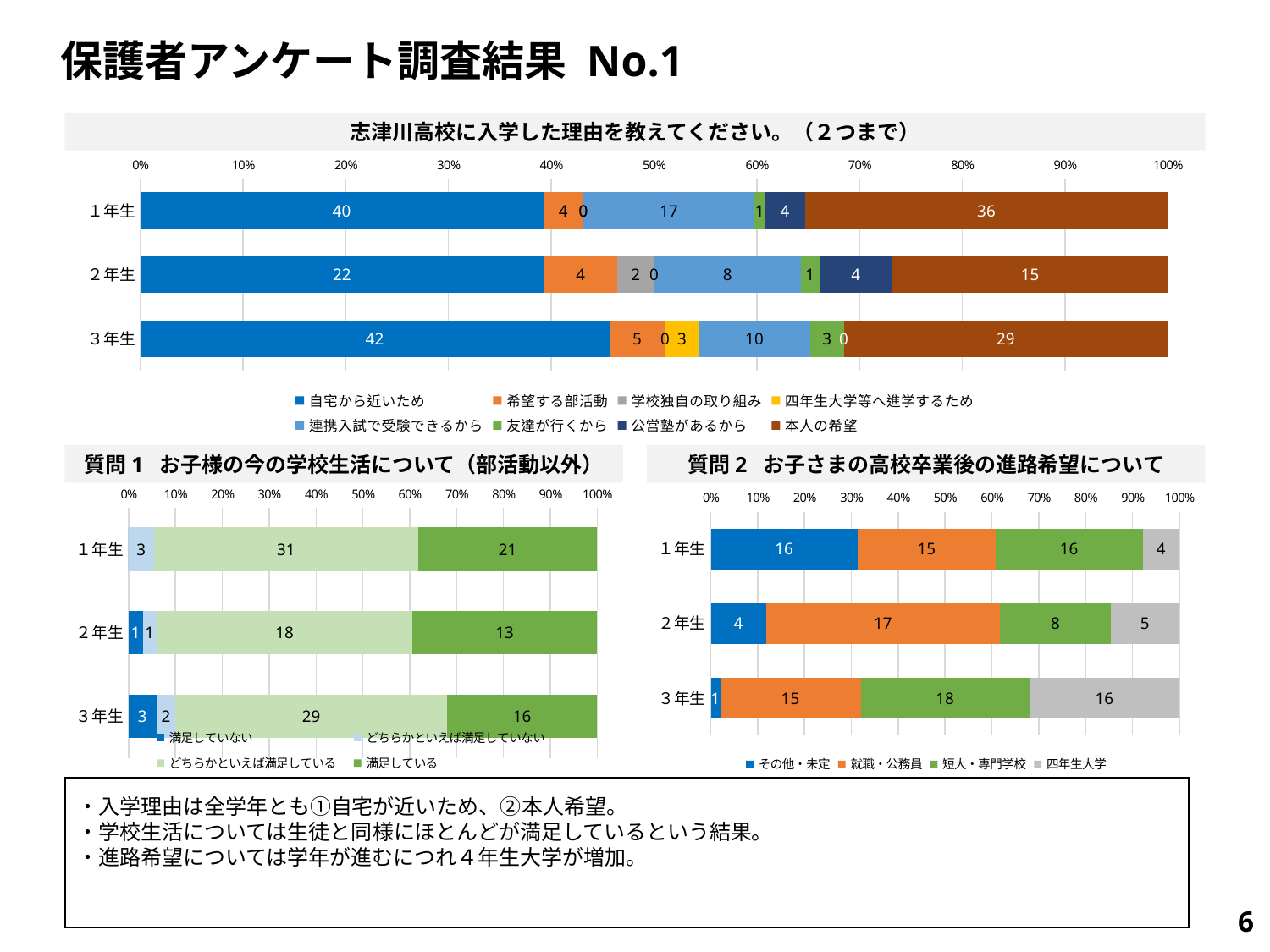
In the 質問1 chart (bottom left), what is the value of どちらかといえば満足している for 1年生? 31 In the 質問2 chart (bottom right), which grade has the highest value for 就職・公務員? 2年生 In the top chart (志津川高校に入学した理由), what is the difference between 自宅から近いため for 3年生 and for 2年生? 20 In the 質問1 chart (bottom left), what is the value of 満足している for 2年生? 13 In the top chart (志津川高校に入学した理由), what is the value of 連携入試で受験できるから for 2年生? 8 In the top chart (志津川高校に入学した理由), what is the value of 自宅から近いため for 3年生? 42 In the 質問2 chart (bottom right), what is the value of 四年生大学 for 3年生? 16 In the 質問2 chart (bottom right), which is larger for 1年生: その他・未定 or 四年生大学? その他・未定 In the 質問2 chart (bottom right), how many grade categories are shown? 3 In the top chart (志津川高校に入学した理由), what is the value of 本人の希望 for 1年生? 36 In the 質問1 chart (bottom left), what kind of chart is shown? Stacked bar chart In the top chart (志津川高校に入学した理由), how many series does the legend list? 8